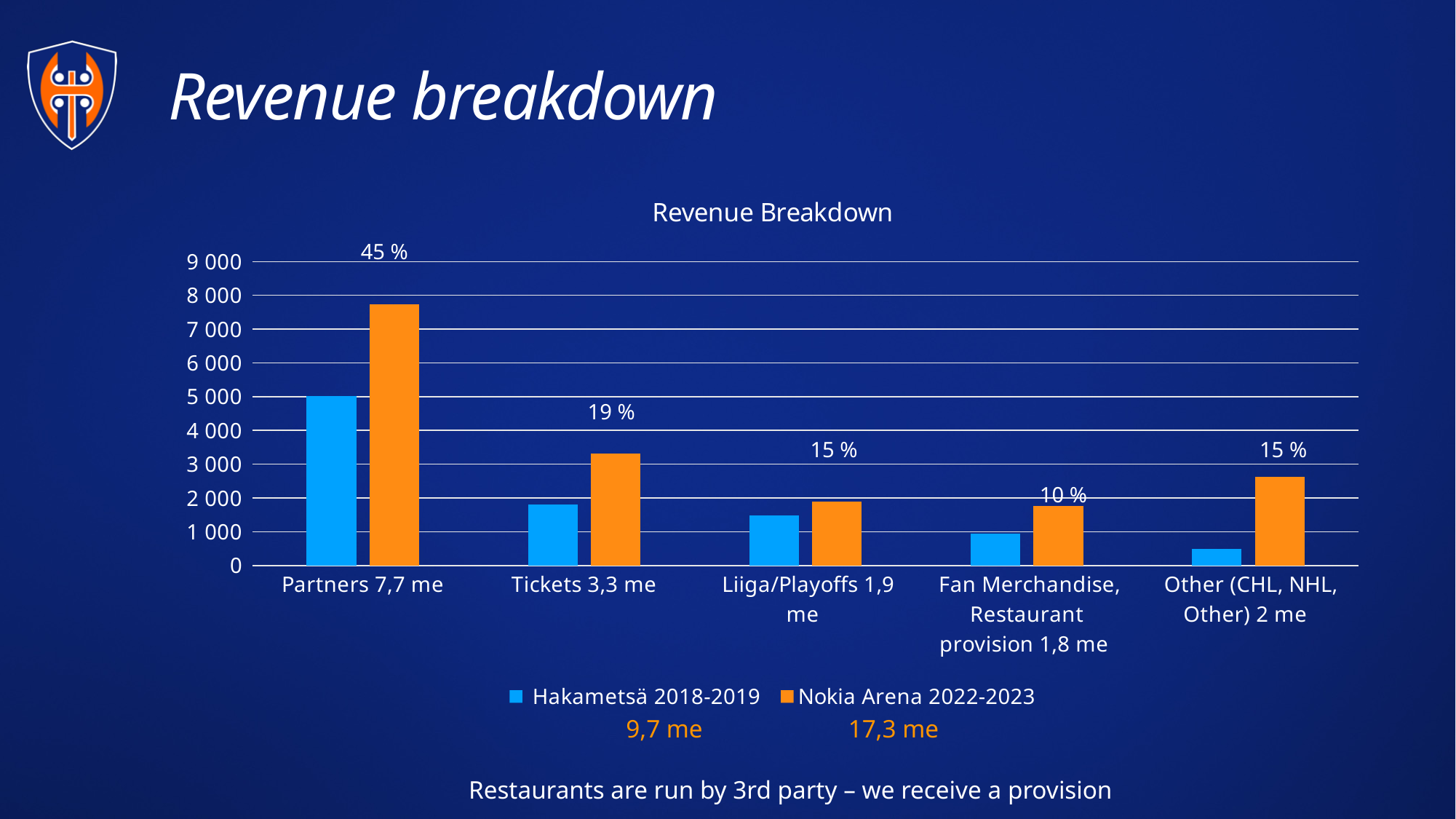
Is the Nokia Arena 2022-2023 value for Partners 7,7 me greater or less than 7 000? greater Is the Hakametsä 2018-2019 value for Tickets 3,3 me greater or less than 2 000? less Which category has the lowest Hakametsä 2018-2019 bar? Other (CHL, NHL, Other) 2 me What percentage label is shown above the Nokia Arena 2022-2023 bar for Tickets 3,3 me? 19 % How many series does the legend list? 2 What percentage label is shown for Fan Merchandise, Restaurant provision 1,8 me? 10 % Which category has the highest Nokia Arena 2022-2023 bar? Partners 7,7 me How many categories are shown on the x axis? 5 What kind of chart is shown on the slide? bar chart For Other (CHL, NHL, Other) 2 me, which series has the larger bar: Hakametsä 2018-2019 or Nokia Arena 2022-2023? Nokia Arena 2022-2023 What percentage label is shown above the Nokia Arena 2022-2023 bar for Partners 7,7 me? 45 % What total is printed under the Nokia Arena 2022-2023 legend entry? 17,3 me